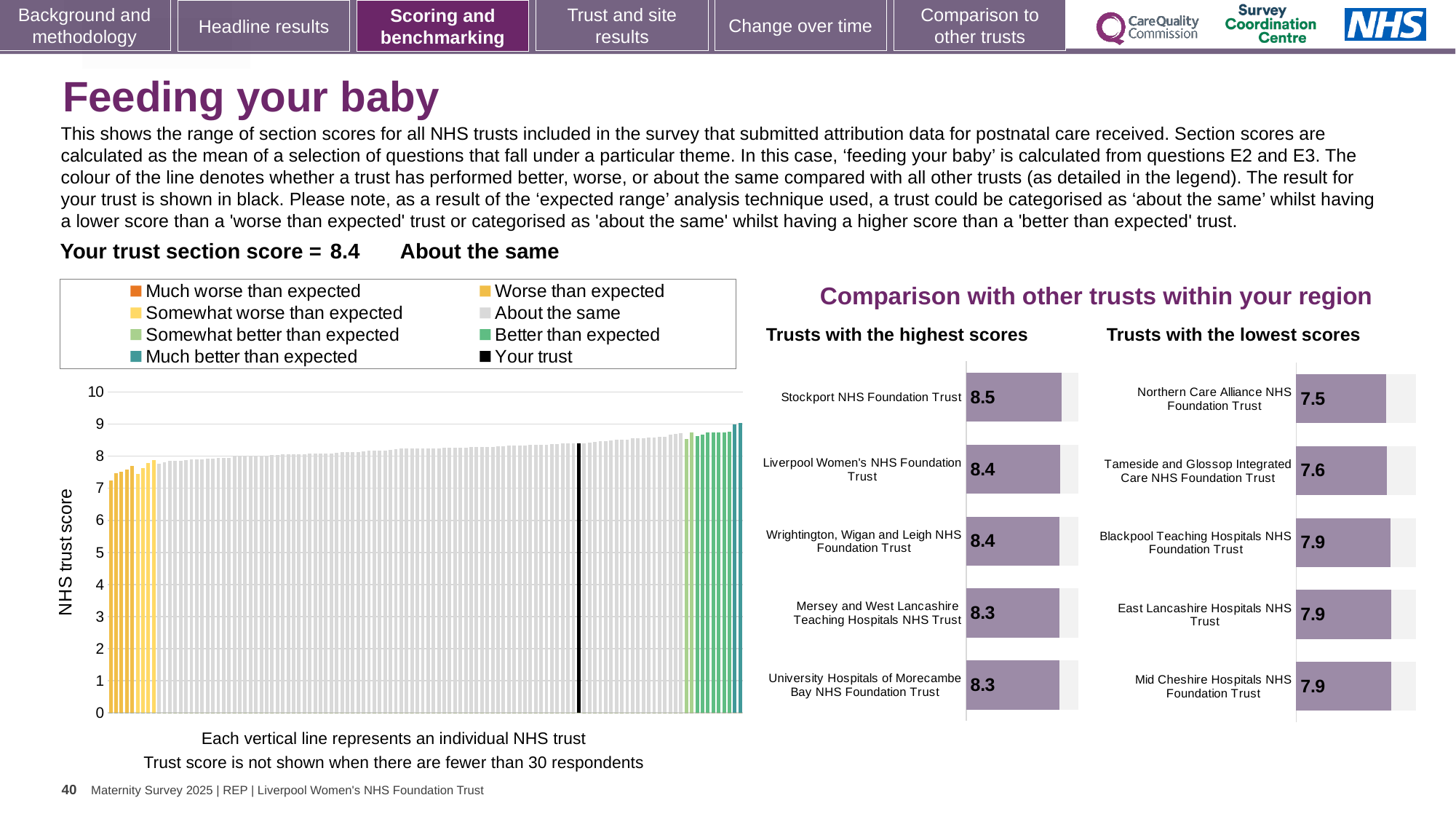
In the 'Trusts with the highest scores' chart, what is the difference between the scores of Stockport NHS Foundation Trust and Mersey and West Lancashire Teaching Hospitals NHS Trust? 0.2 In the 'Trusts with the highest scores' chart, which trust has the highest score? Stockport NHS Foundation Trust In the 'Trusts with the lowest scores' chart, which has the larger score: Blackpool Teaching Hospitals NHS Foundation Trust or Tameside and Glossop Integrated Care NHS Foundation Trust? Blackpool Teaching Hospitals NHS Foundation Trust How many trusts are shown in the 'Trusts with the lowest scores' chart? 5 In the large chart on the left, do the trust scores rise or fall from left to right? Rise In the large chart on the left, is the value of the black 'Your trust' bar greater or less than 8? greater In the 'Trusts with the lowest scores' chart, what is the score for Northern Care Alliance NHS Foundation Trust? 7.5 In the 'Trusts with the lowest scores' chart, which trust has the lowest score? Northern Care Alliance NHS Foundation Trust In the 'Trusts with the lowest scores' chart, what is the score for Tameside and Glossop Integrated Care NHS Foundation Trust? 7.6 In the 'Trusts with the highest scores' chart, what is the score for Stockport NHS Foundation Trust? 8.5 How many entries does the legend of the large chart on the left list? 8 What kind of chart is the large chart on the left showing NHS trust scores? Bar chart